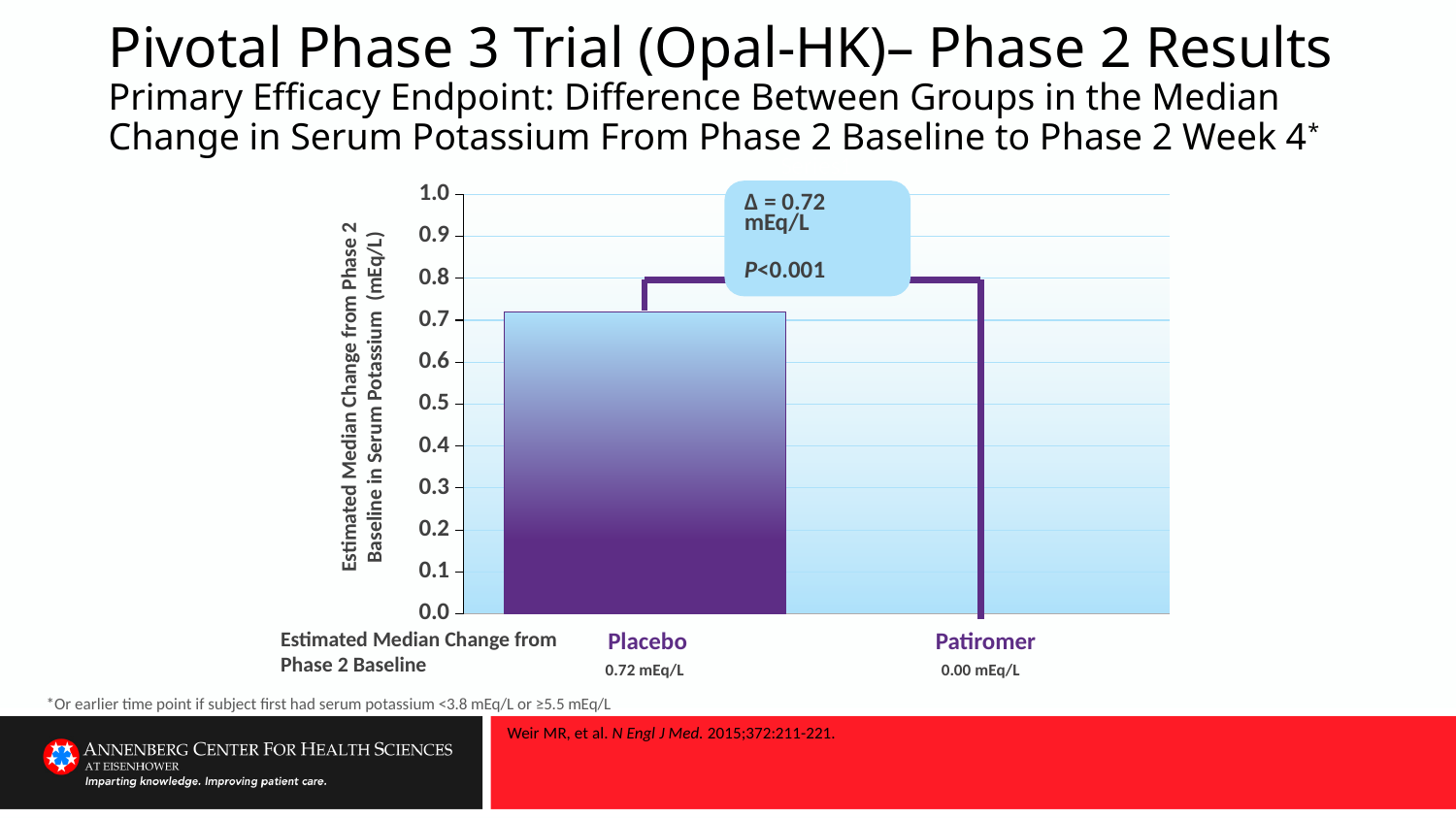
How many groups are shown on the x axis of the chart? 2 What is the estimated median change from Phase 2 baseline for the Placebo group? 0.72 mEq/L Which group has the higher estimated median change from Phase 2 baseline? Placebo What is the difference between the Placebo and Patiromer values? 0.72 mEq/L What P value is shown in the callout box above the bars? P<0.001 Is the value for Placebo greater or less than 0.5? greater Which group has the lower estimated median change from Phase 2 baseline? Patiromer Is the value for Placebo larger or smaller than the value for Patiromer? larger What kind of chart is shown on the slide? Bar chart What is the estimated median change from Phase 2 baseline for the Patiromer group? 0.00 mEq/L What is the maximum value shown on the y axis of the chart? 1.0